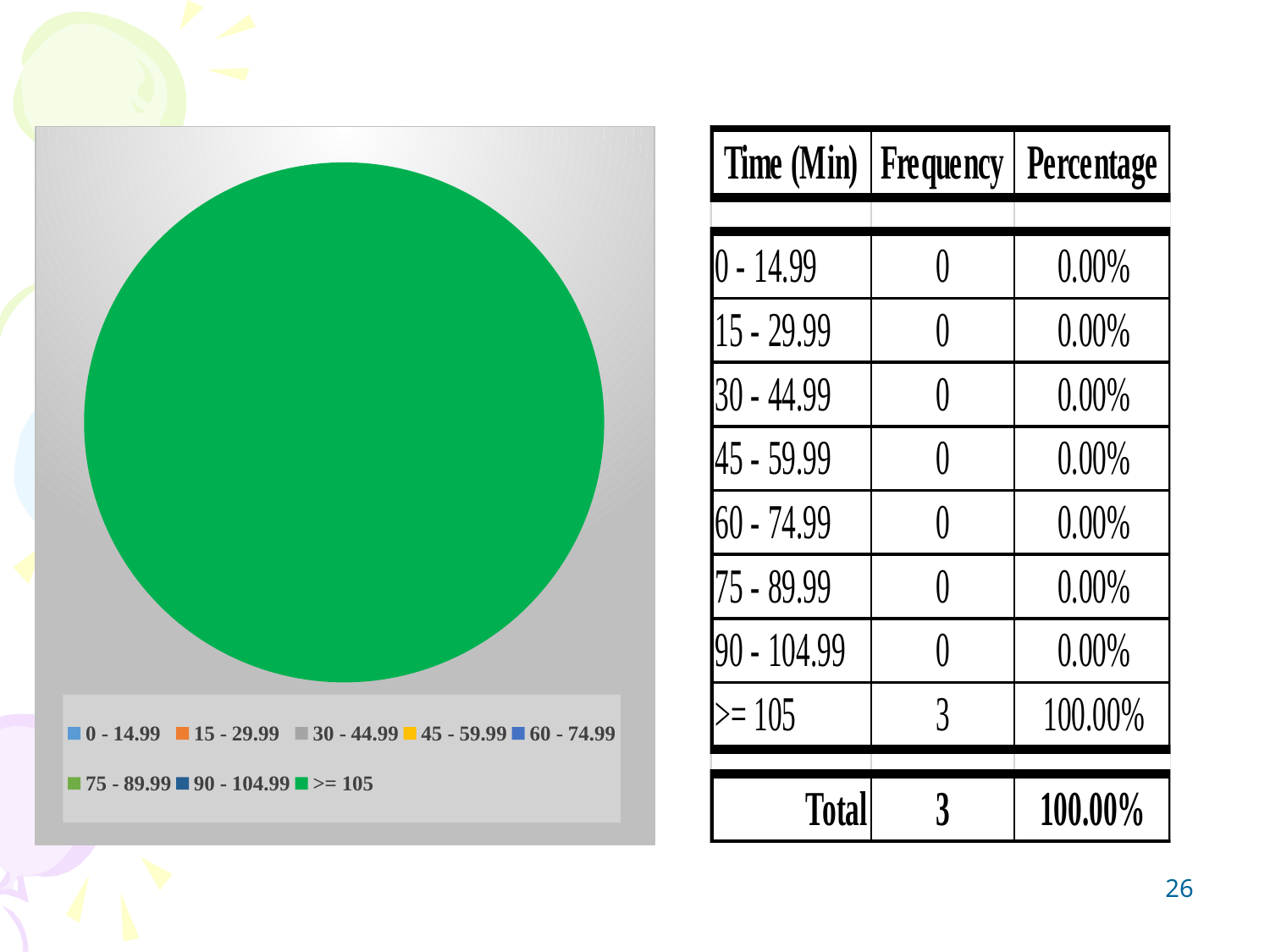
How many slices are visibly drawn in the pie chart? 1 What is the first category listed in the pie chart's legend? 0 - 14.99 What is the frequency for the >= 105 category? 3 How many categories does the pie chart's legend list? 8 What colour is the slice for the >= 105 category in the pie chart? green What is the percentage for the 30 - 44.99 category? 0.00% What share of the pie does the >= 105 category represent? 100.00% What is the total frequency across all categories? 3 Which category accounts for the largest share of the pie chart? >= 105 Which is larger in the pie chart, the share for >= 105 or the share for 0 - 14.99? >= 105 What kind of chart is shown on the slide? pie chart